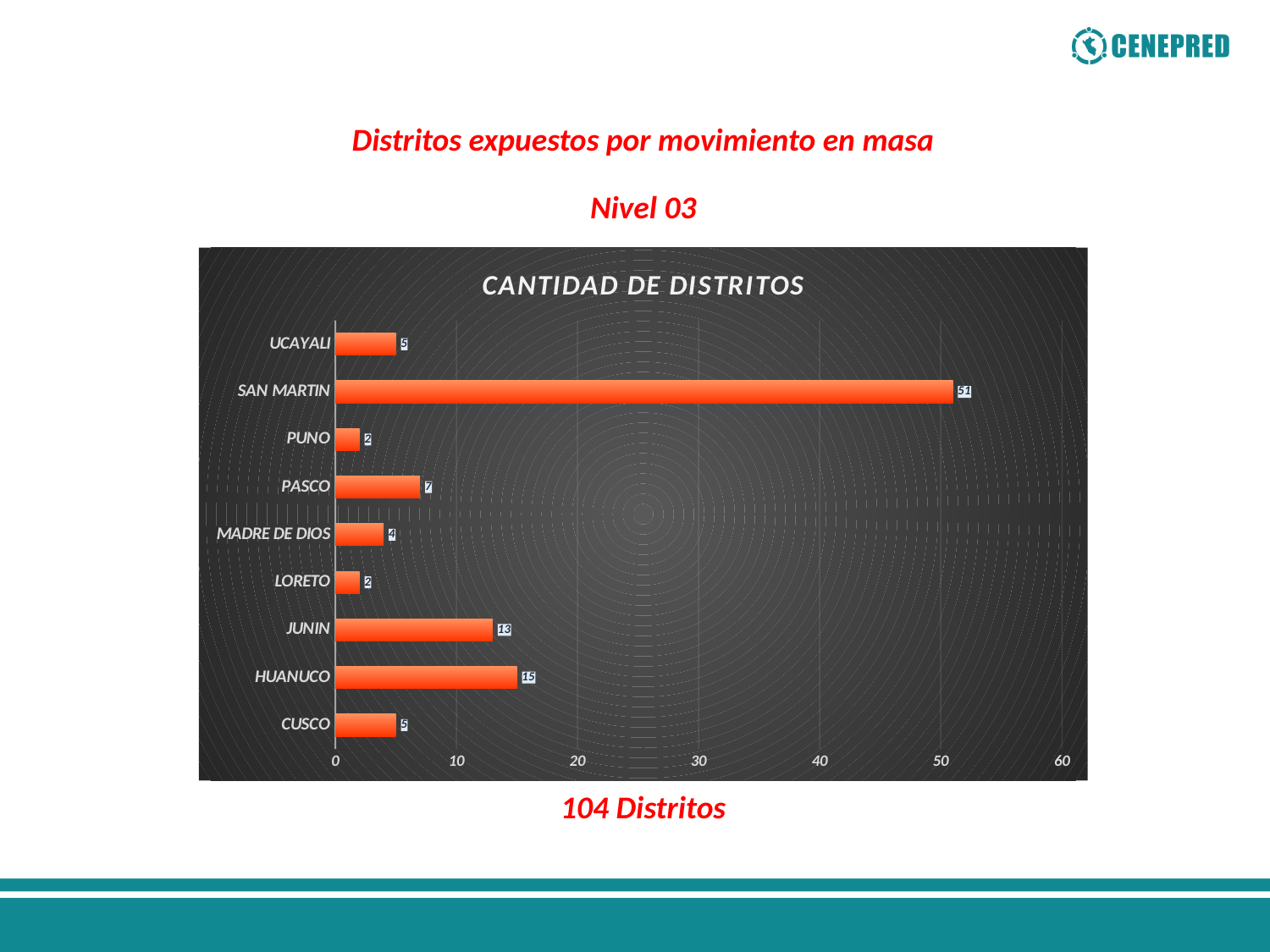
What is the value for SAN MARTIN? 51 What is the value for MADRE DE DIOS? 4 What is the difference between the values for SAN MARTIN and HUANUCO? 36 What is the difference between the values for HUANUCO and JUNIN? 2 Which category has the highest value? SAN MARTIN What is the value for JUNIN? 13 What is the value for HUANUCO? 15 Which is larger, the value for PASCO or the value for UCAYALI? PASCO What kind of chart is shown on the slide? bar chart How many categories are shown in the chart? 9 Is the value for SAN MARTIN greater or less than 40? greater What is the title of the chart? CANTIDAD DE DISTRITOS